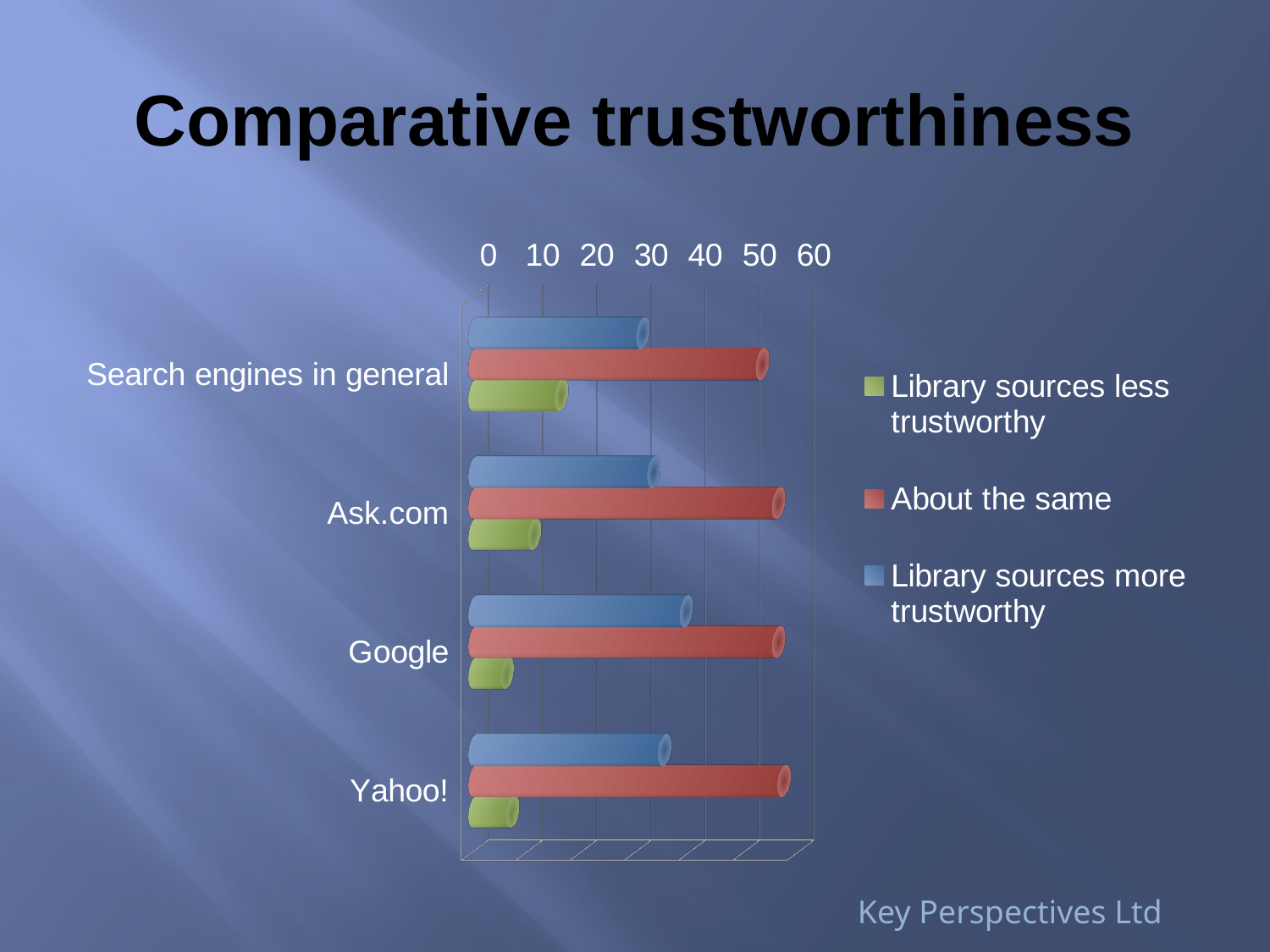
Is the 'About the same' value for Search engines in general greater or less than 40? greater For Search engines in general, which is larger: 'Library sources more trustworthy' or 'Library sources less trustworthy'? Library sources more trustworthy Is the 'About the same' value for Yahoo! greater or less than 50? greater What colour represents the 'About the same' series in the legend? red How many categories are plotted on the chart? 4 Is the 'Library sources less trustworthy' value for Ask.com greater or less than 20? less Which category has the highest 'Library sources less trustworthy' value? Search engines in general How many series does the legend list? 3 What kind of chart is shown on the slide? bar chart For Google, which is larger: 'About the same' or 'Library sources less trustworthy'? About the same